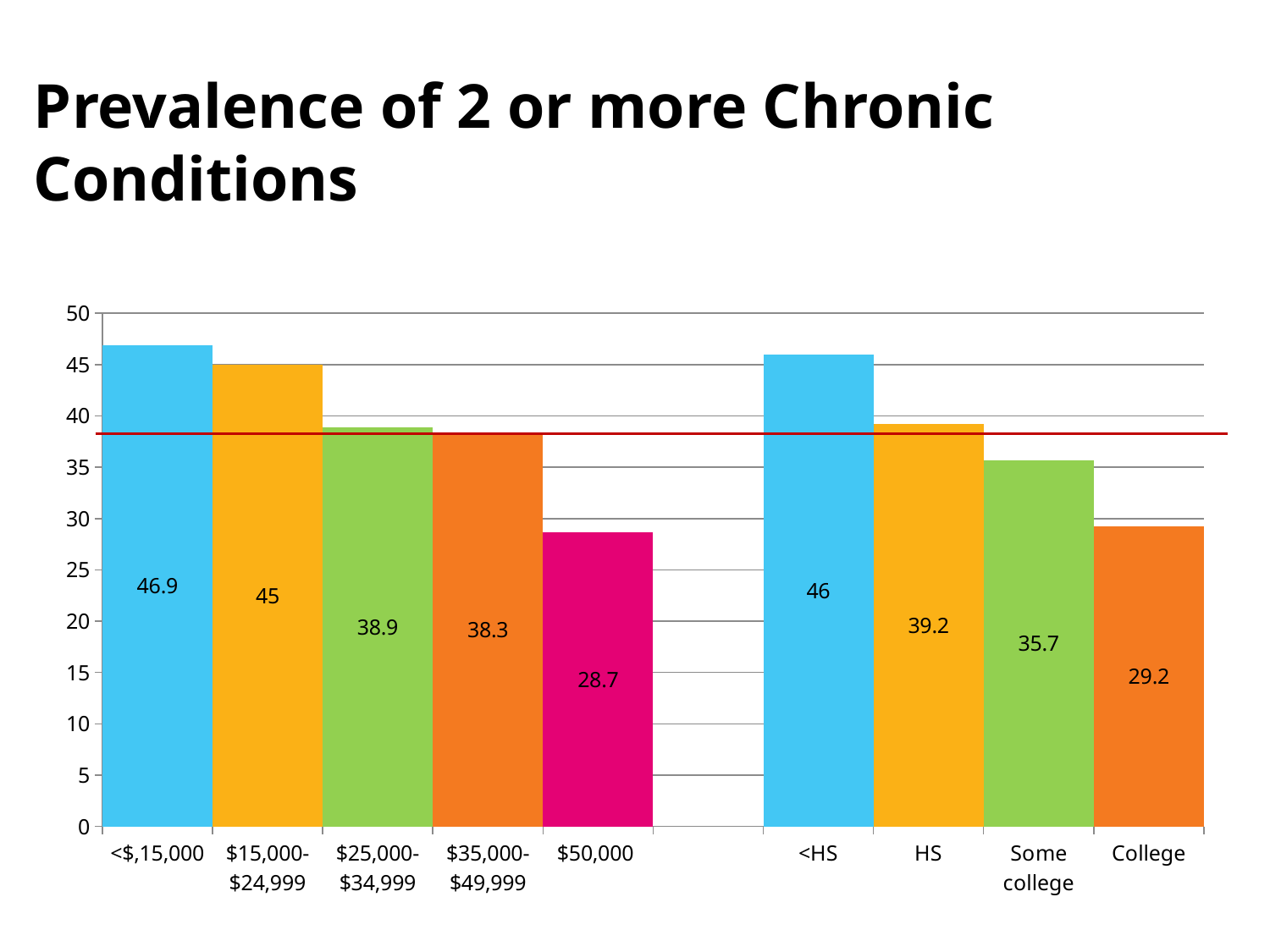
What is the difference between the values for <HS and College? 16.8 What is the value for the Some college category? 35.7 Which category has the highest value on the chart? <$,15,000 Do the values rise or fall across the income categories from <$,15,000 to $50,000? Fall What is the value for the College education category? 29.2 Which is larger, the value for HS or the value for $15,000-$24,999? $15,000-$24,999 What kind of chart is shown on the slide? Bar chart What is the value for the <$,15,000 income category? 46.9 Which category has the lowest value on the chart? $50,000 What is the value for the $35,000-$49,999 income category? 38.3 How many bars are plotted on the chart? 9 What is the difference between the values for <$,15,000 and $50,000? 18.2